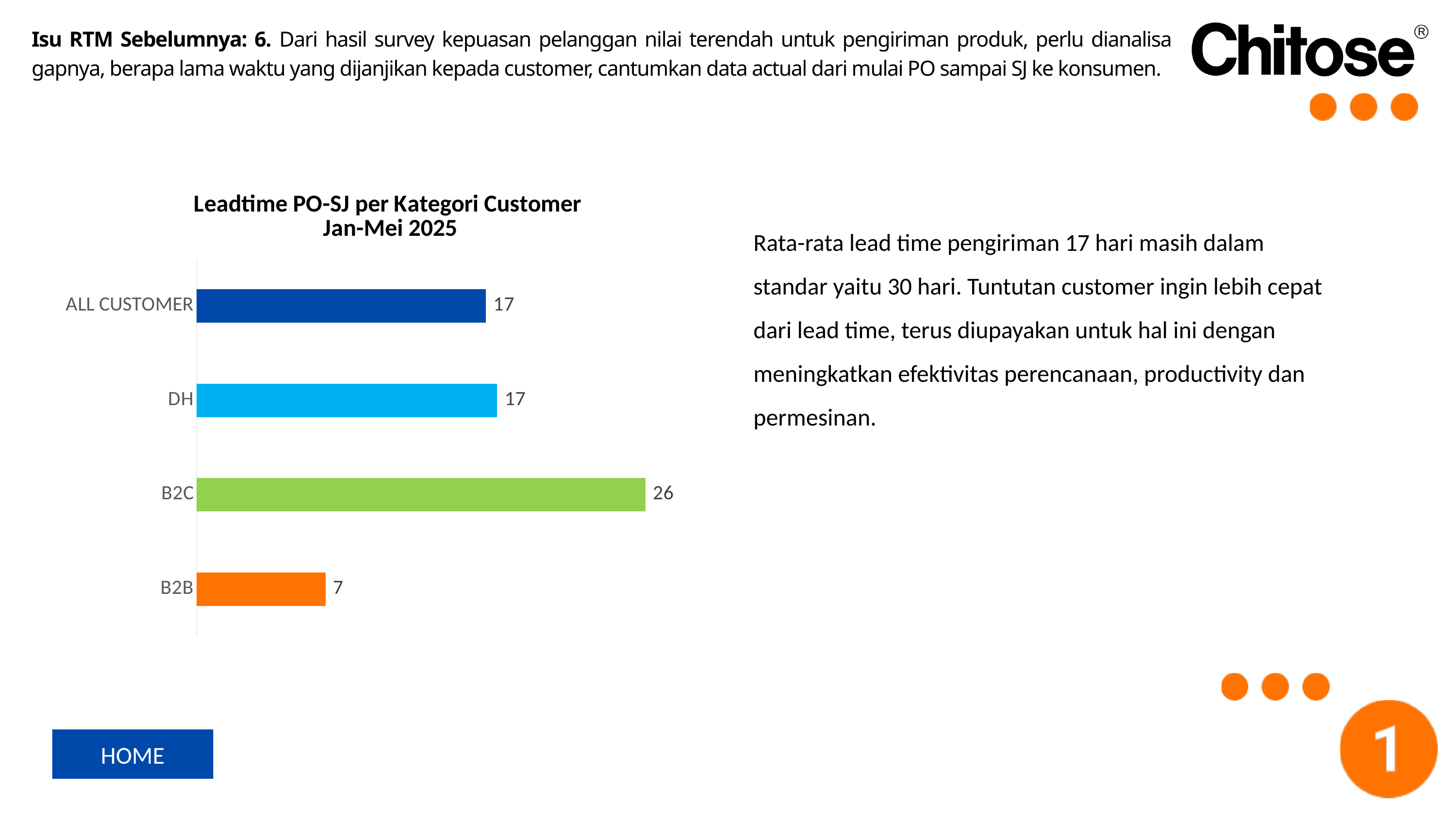
What is the leadtime value for ALL CUSTOMER? 17 What is the title of the chart? Leadtime PO-SJ per Kategori Customer Jan-Mei 2025 Which category has the lowest leadtime? B2B What is the leadtime value for B2B? 7 What kind of chart is shown on the slide? Bar chart Which category has the highest leadtime? B2C What is the leadtime value for B2C? 26 How many customer categories are shown in the chart? 4 What is the leadtime value for DH? 17 Which is larger, the leadtime for DH or for B2B? DH What is the difference between the leadtime for B2C and B2B? 19 What is the difference between the leadtime for B2C and DH? 9